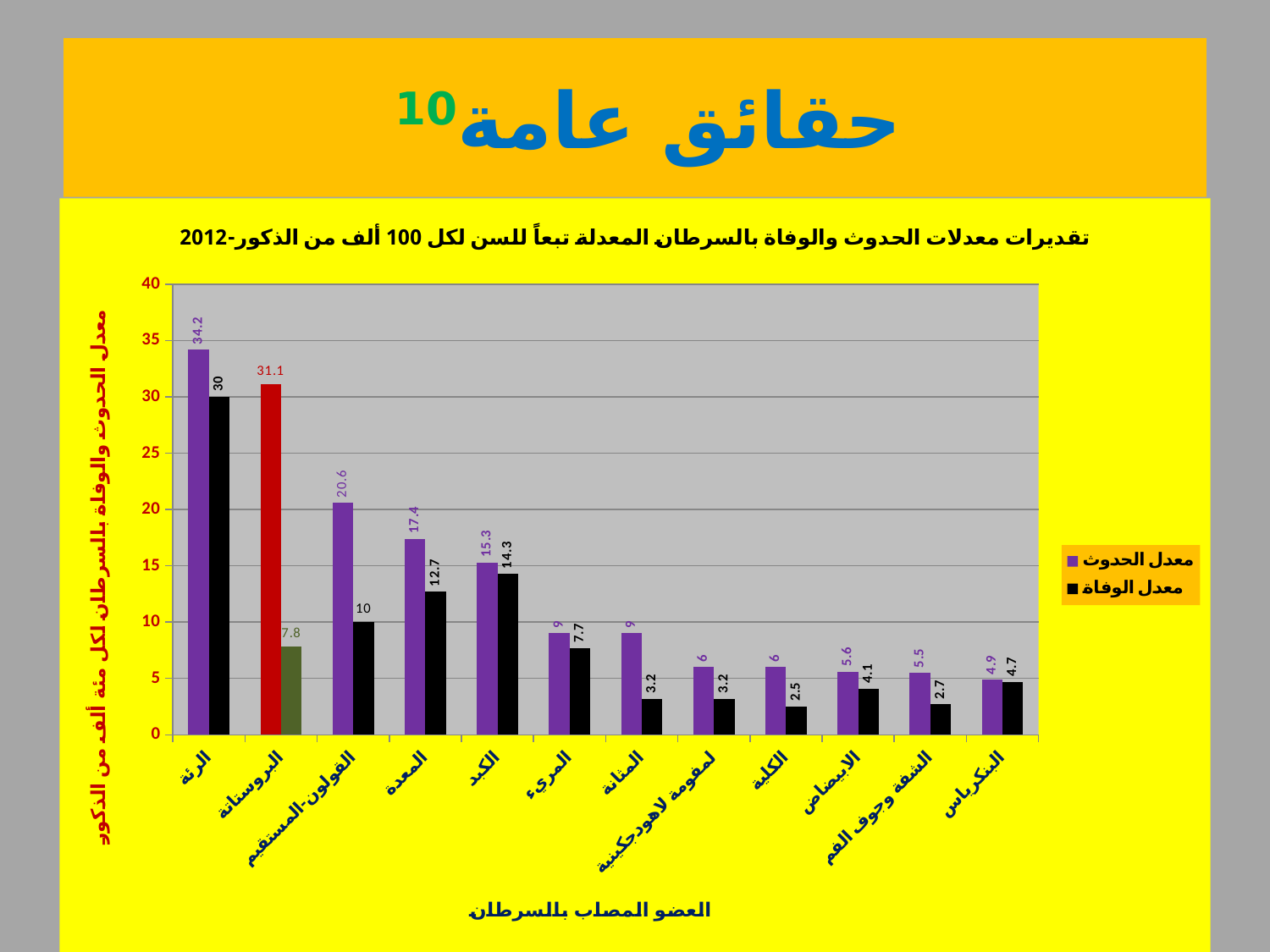
What kind of chart is shown on the slide? bar chart Which is larger: the incidence rate for القولون-المستقيم or the incidence rate for المعدة? القولون-المستقيم Which organ has the lowest mortality rate (معدل الوفاة)? الكلية What is the mortality rate (معدل الوفاة) for الكبد (liver)? 14.3 Which organ has the highest incidence rate (معدل الحدوث)? الرئة What is the x-axis title of the chart? العضو المصاب بالسرطان What is the difference between the incidence rate and the mortality rate for البروستاتا (prostate)? 23.3 What is the incidence rate (معدل الحدوث) for الرئة (lung)? 34.2 What is the mortality rate (معدل الوفاة) for البروستاتا (prostate)? 7.8 How many series does the legend list? 2 Is the incidence rate for الرئة (lung) greater or less than 30? greater How many organ categories are shown on the x axis? 12